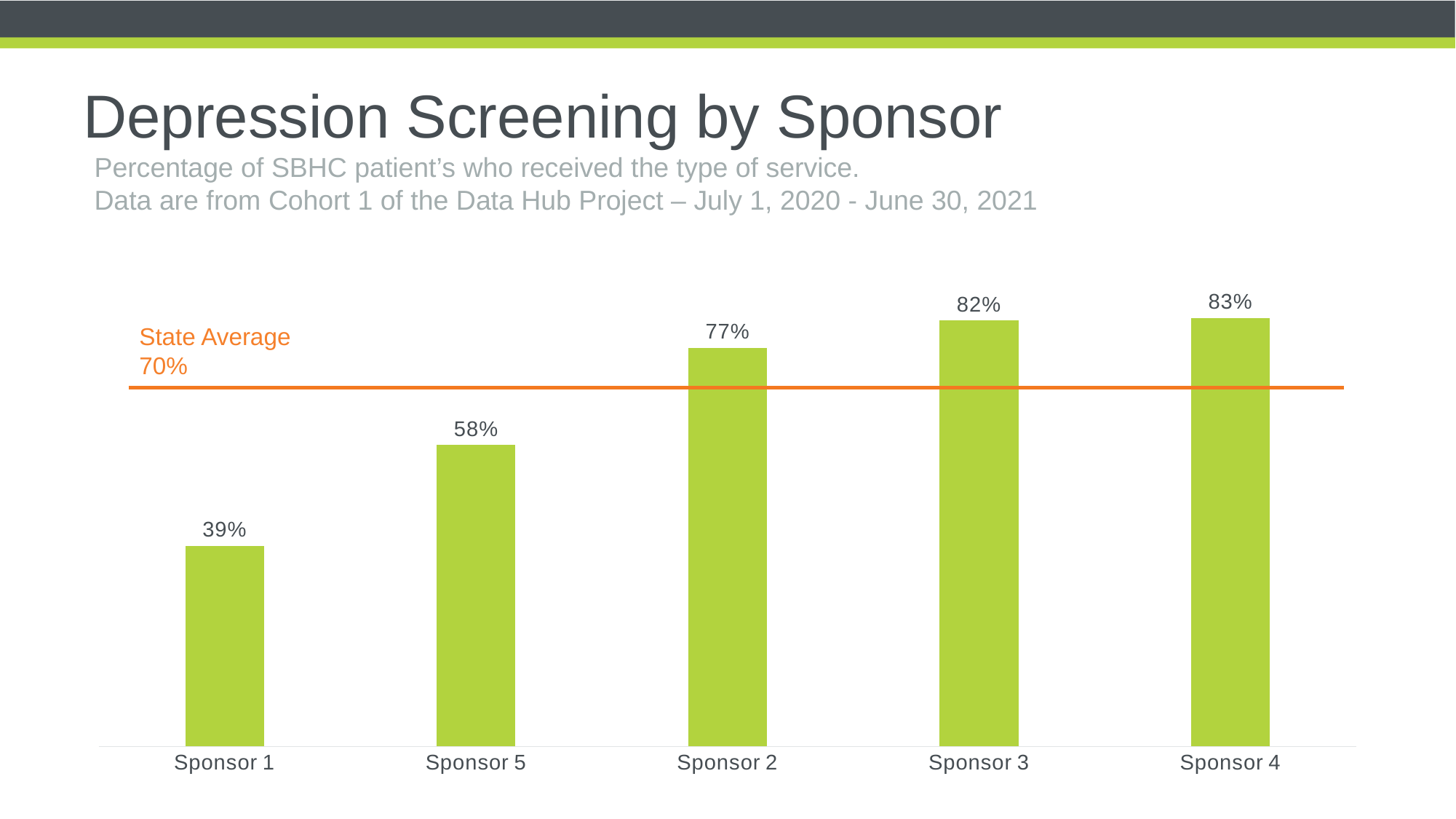
How many sponsors are shown in the chart? 5 What is the difference between the depression screening percentages of Sponsor 4 and Sponsor 5? 25% What is the State Average value marked by the orange line on the chart? 70% What is the difference between the depression screening percentages of Sponsor 2 and Sponsor 1? 38% What kind of chart is shown on the slide? Bar chart Do the depression screening percentages rise or fall from left to right across the sponsors? Rise What is the depression screening percentage for Sponsor 3? 82% Which has a higher depression screening percentage, Sponsor 5 or Sponsor 2? Sponsor 2 Which sponsor has the highest depression screening percentage? Sponsor 4 Which sponsor has the lowest depression screening percentage? Sponsor 1 What is the depression screening percentage for Sponsor 1? 39% What is the depression screening percentage for Sponsor 5? 58%